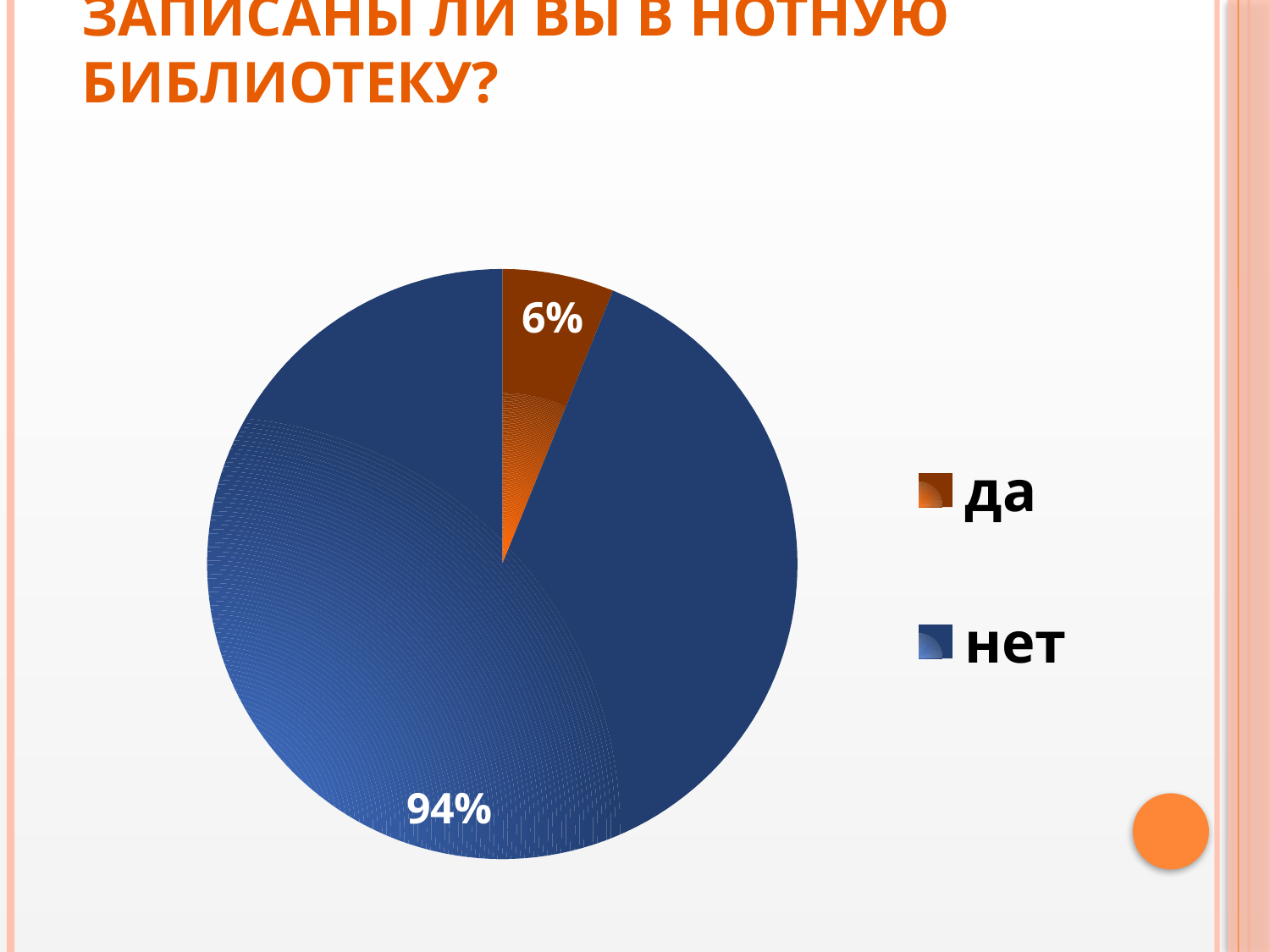
What kind of chart is shown on the slide? pie chart What colour is the slice for "нет"? blue Which is larger, the share for "да" or the share for "нет"? нет What share of the pie does "нет" have? 94% How many slices does the pie chart have? 2 What colour is the slice for "да"? orange Which category has the smallest slice of the pie? да How many entries does the legend list? 2 What share of the pie does "да" have? 6% Which category has the largest slice of the pie? нет What is the difference in percentage points between "нет" and "да"? 88